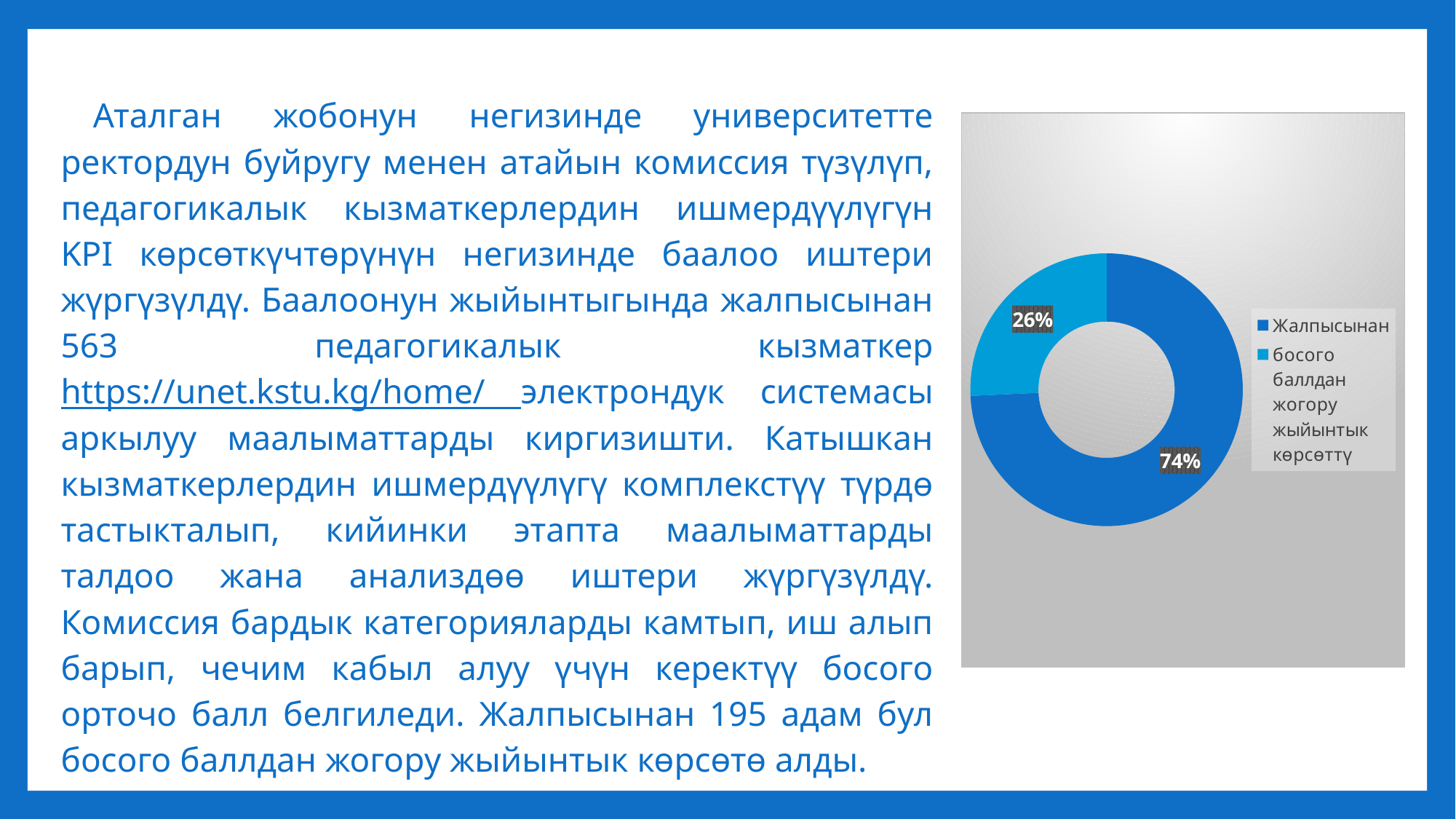
What kind of chart is shown on the slide? doughnut chart How many slices does the chart have? 2 What is the difference in percentage points between the "Жалпысынан" slice and the "босого баллдан жогору жыйынтык көрсөттү" slice? 48 On which side of the chart is the legend placed? right Which is larger: the "Жалпысынан" slice or the "босого баллдан жогору жыйынтык көрсөттү" slice? Жалпысынан Which slice of the chart is the smallest? босого баллдан жогору жыйынтык көрсөттү What percentage is shown for the "босого баллдан жогору жыйынтык көрсөттү" slice? 26% Which slice of the chart is the largest? Жалпысынан How many entries does the legend list? 2 What percentage is shown for the "Жалпысынан" slice? 74% What share of the chart does the "босого баллдан жогору жыйынтык көрсөттү" slice represent? 26% Which legend entry is shown in the lighter blue colour? босого баллдан жогору жыйынтык көрсөттү